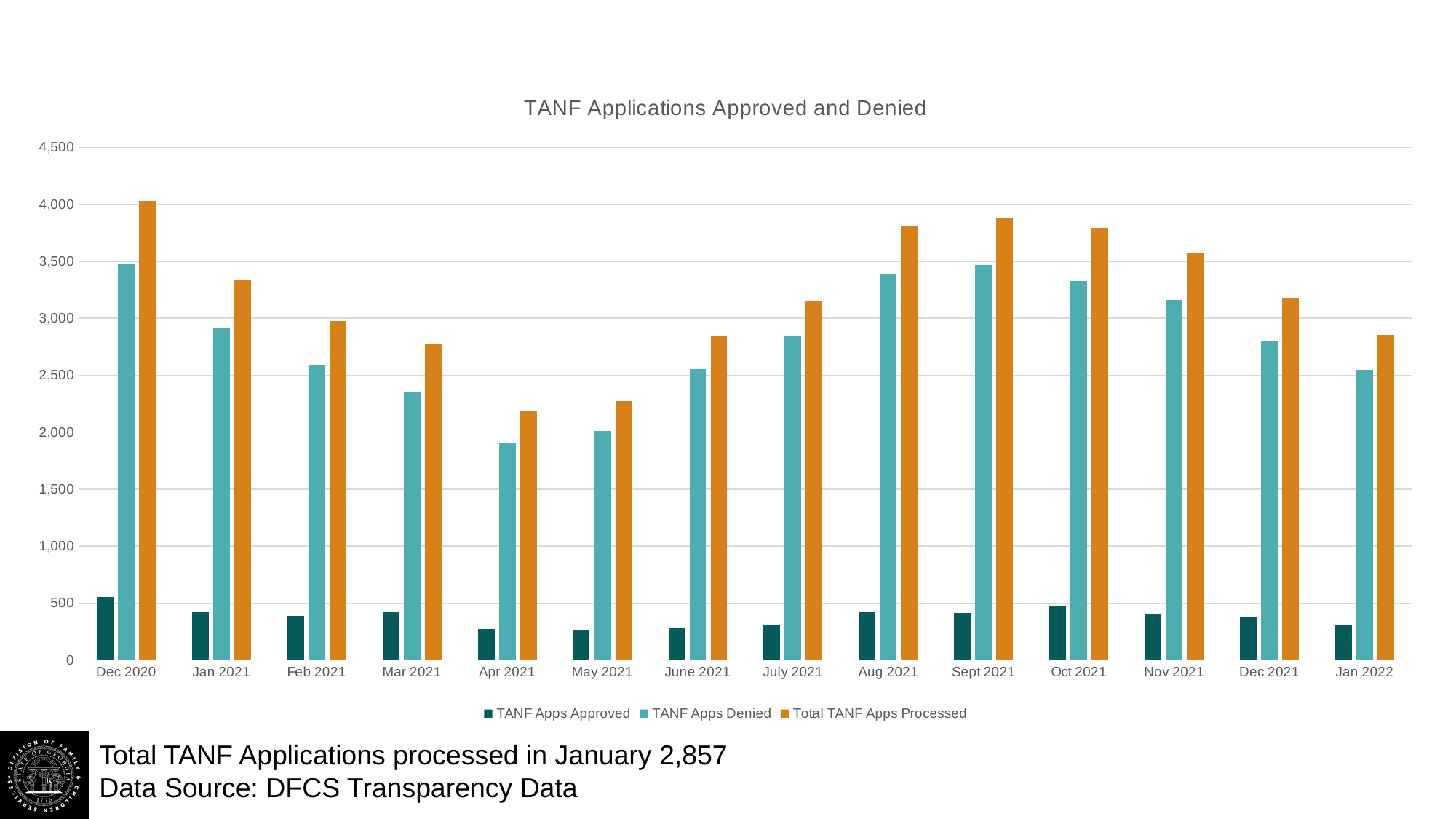
In which month is the TANF Apps Approved bar the highest? Dec 2020 Do the Total TANF Apps Processed values rise or fall from Dec 2020 to Apr 2021? fall How many series does the legend list? 3 According to the slide, what was the total number of TANF applications processed in January 2022? 2,857 How many months are shown on the x axis of the chart? 14 Is the value for TANF Apps Denied in Apr 2021 greater or less than 2,000? less Which month has more TANF Apps Denied, Jan 2021 or Feb 2021? Jan 2021 In which month is the Total TANF Apps Processed bar the highest? Dec 2020 Is the value for Total TANF Apps Processed in Aug 2021 greater or less than 3,500? greater What kind of chart is shown on the slide? Bar chart What is the title of the chart? TANF Applications Approved and Denied In which month is the Total TANF Apps Processed bar the lowest? Apr 2021